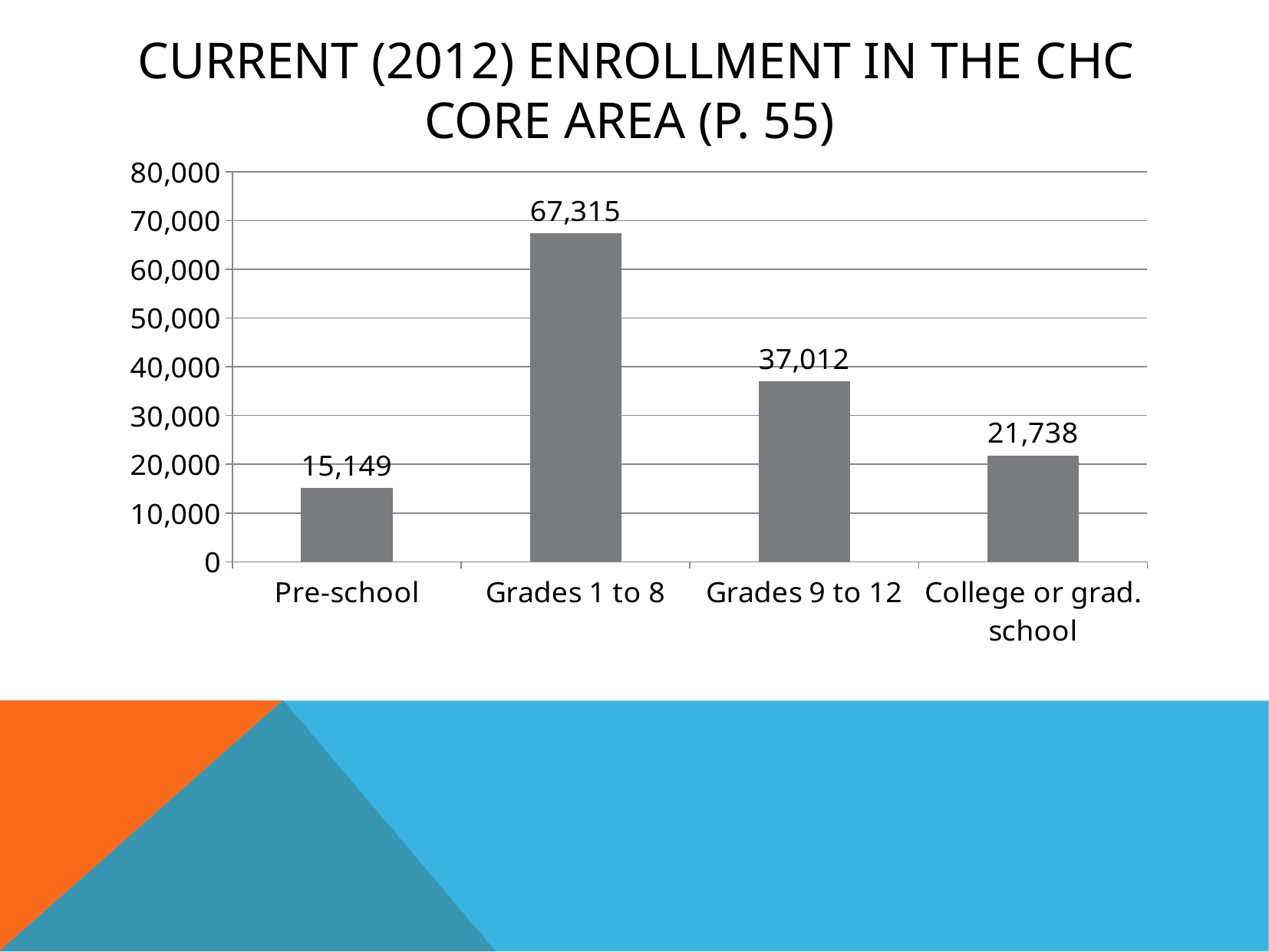
What is the enrollment value for Grades 1 to 8? 67,315 What is the difference in enrollment between Grades 1 to 8 and Grades 9 to 12? 30,303 What is the enrollment value for Grades 9 to 12? 37,012 How many categories are shown in the chart? 4 Which has a larger enrollment, Grades 9 to 12 or College or grad. school? Grades 9 to 12 What is the enrollment value for College or grad. school? 21,738 Is the value for Grades 9 to 12 greater or less than 40,000? less What kind of chart is shown on the slide? Bar chart What is the enrollment value for Pre-school? 15,149 Which category has the lowest enrollment? Pre-school What is the difference in enrollment between College or grad. school and Pre-school? 6,589 Which category has the highest enrollment? Grades 1 to 8